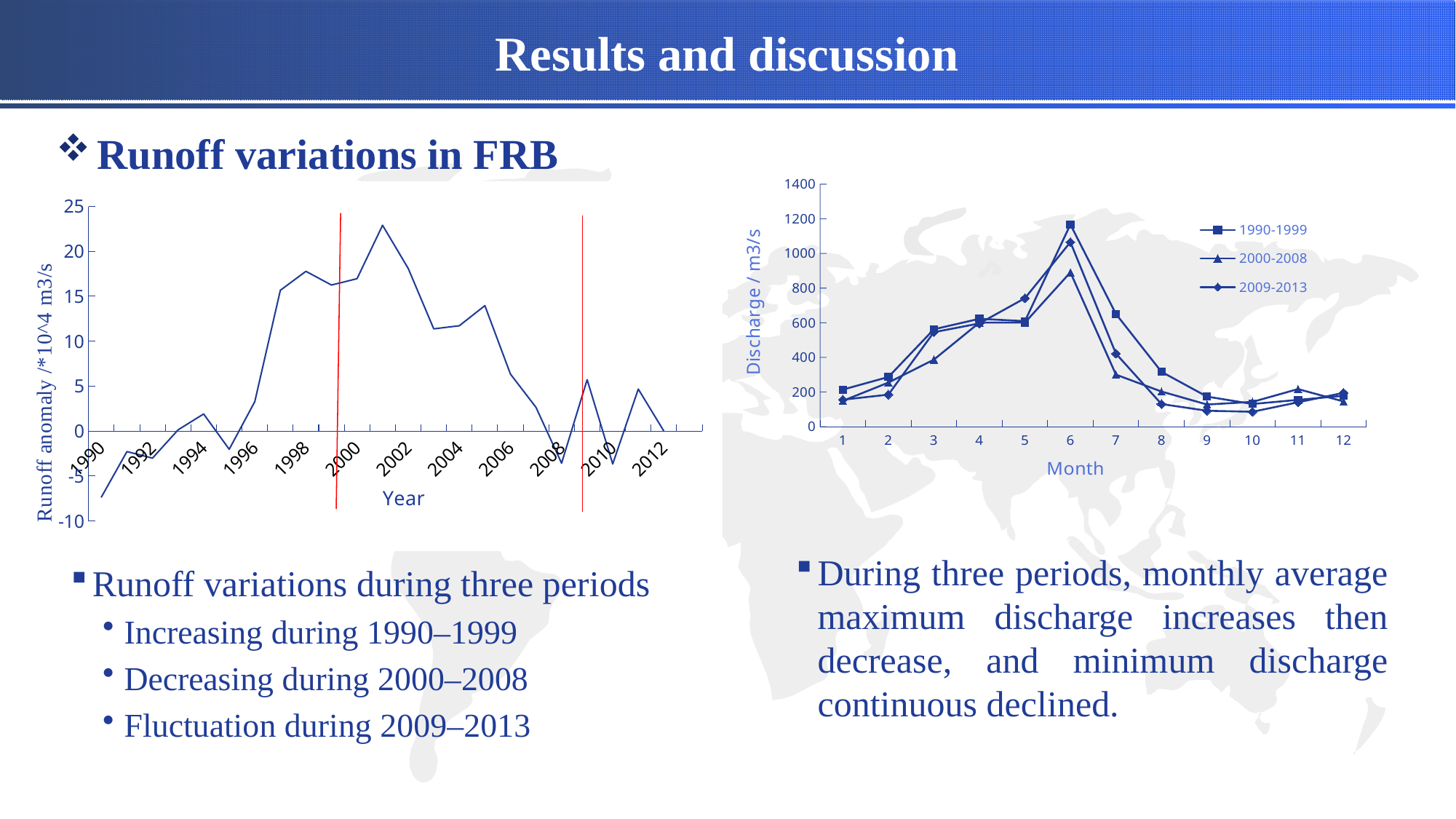
What kind of chart is the left chart showing runoff anomaly by year? line chart In the right discharge chart, is the 1990-1999 value for month 6 greater or less than 1000? greater In the right discharge chart, which series has the highest discharge in month 6? 1990-1999 How many months are plotted along the x axis of the right discharge chart? 12 How many series does the legend of the right discharge chart list? 3 In the left runoff anomaly chart, which year has the highest runoff anomaly? 2001 In the left runoff anomaly chart, which is larger, the value for 1998 or the value for 2006? 1998 In the left runoff anomaly chart, is the value for 2001 greater or less than 20? greater In the right discharge chart, which is larger in month 7, the 1990-1999 value or the 2000-2008 value? 1990-1999 In the left runoff anomaly chart, do the values rise or fall from 2005 to 2008? fall In the left runoff anomaly chart, is the value for 1990 greater or less than -5? less What is the y-axis label of the right chart? Discharge / m3/s